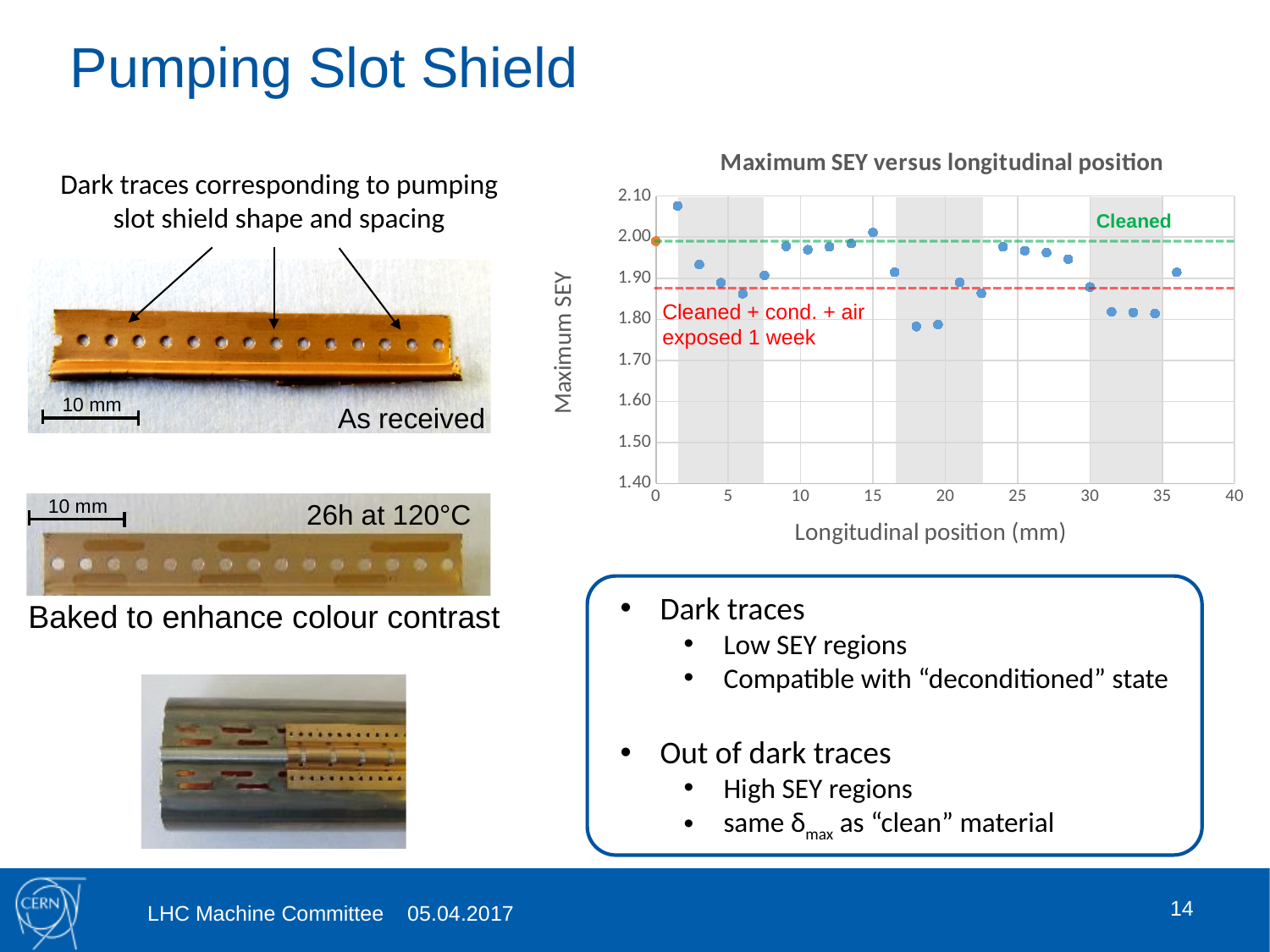
What is the title of the chart? Maximum SEY versus longitudinal position Which of the two dashed reference lines lies higher on the chart, the 'Cleaned' line or the 'Cleaned + cond. + air exposed 1 week' line? Cleaned Is the 'Cleaned' dashed reference line above or below 1.90 on the Maximum SEY axis? above What kind of chart is shown on the slide? Scatter chart Is the maximum SEY value at a longitudinal position of about 3 mm greater or less than 1.90? greater What is the label of the x axis of the chart? Longitudinal position (mm) Is the highest plotted maximum SEY value greater or less than 2.00? greater What is the lowest value shown on the Maximum SEY axis? 1.40 Is the maximum SEY value at a longitudinal position of about 18 mm greater or less than 1.80? less